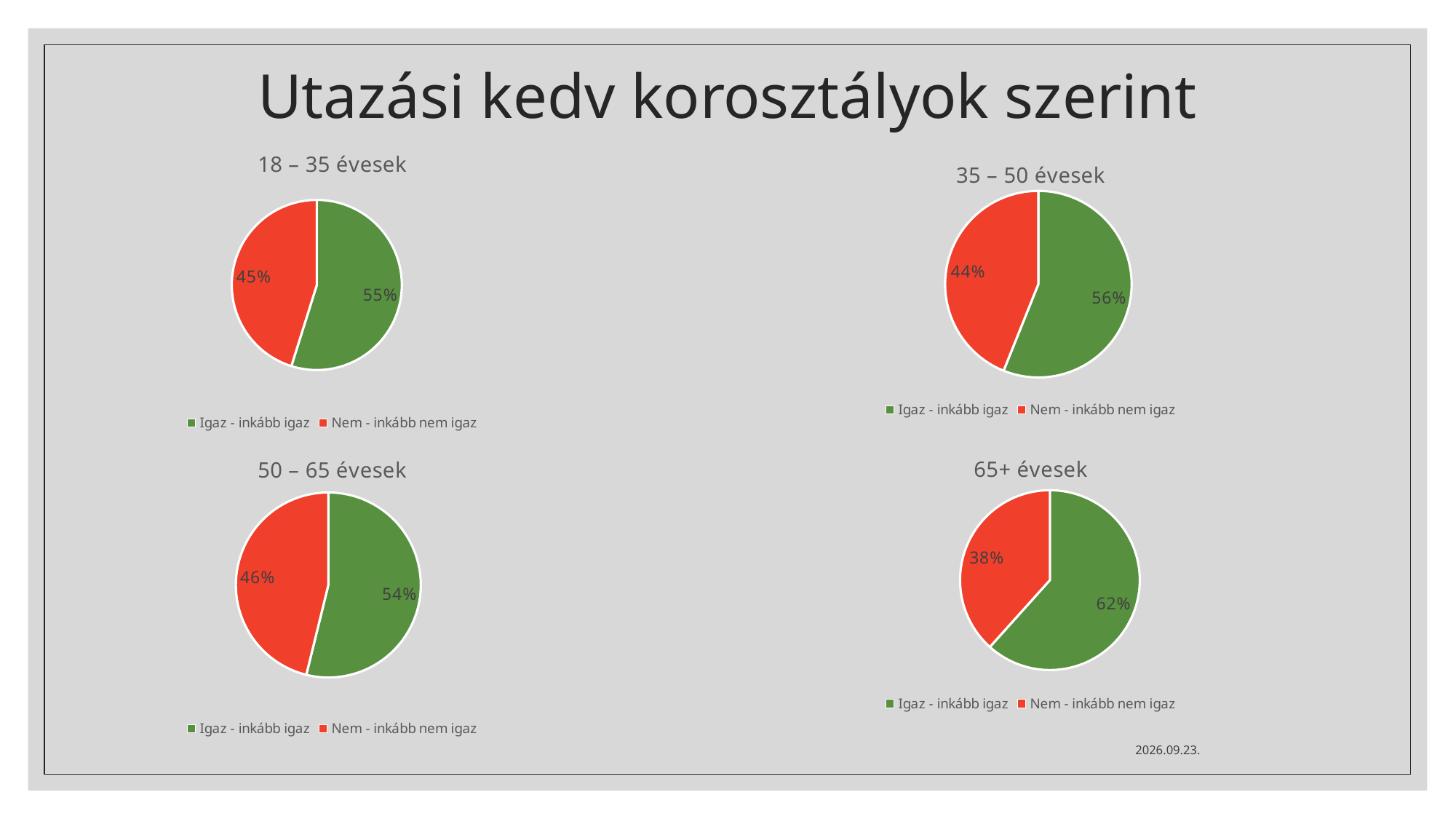
In the "35 – 50 évesek" chart, which is larger: "Igaz - inkább igaz" or "Nem - inkább nem igaz"? Igaz - inkább igaz In the "65+ évesek" chart, what share is labelled for "Nem - inkább nem igaz"? 38% In the "65+ évesek" chart, what is the difference between the "Igaz - inkább igaz" and "Nem - inkább nem igaz" shares? 24% In the "50 – 65 évesek" chart, what share is labelled for "Igaz - inkább igaz"? 54% What kind of chart is the "50 – 65 évesek" chart? Pie chart How many slices does the "35 – 50 évesek" chart have? 2 In the "18 – 35 évesek" chart, what share is labelled for "Igaz - inkább igaz"? 55% In the "65+ évesek" chart, which slice is the largest? Igaz - inkább igaz In the "18 – 35 évesek" chart, which slice is the smallest? Nem - inkább nem igaz In the "35 – 50 évesek" chart, what share is labelled for "Nem - inkább nem igaz"? 44% In the "50 – 65 évesek" chart, what colour is the "Nem - inkább nem igaz" slice? Red How many entries does the legend of the "18 – 35 évesek" chart list? 2